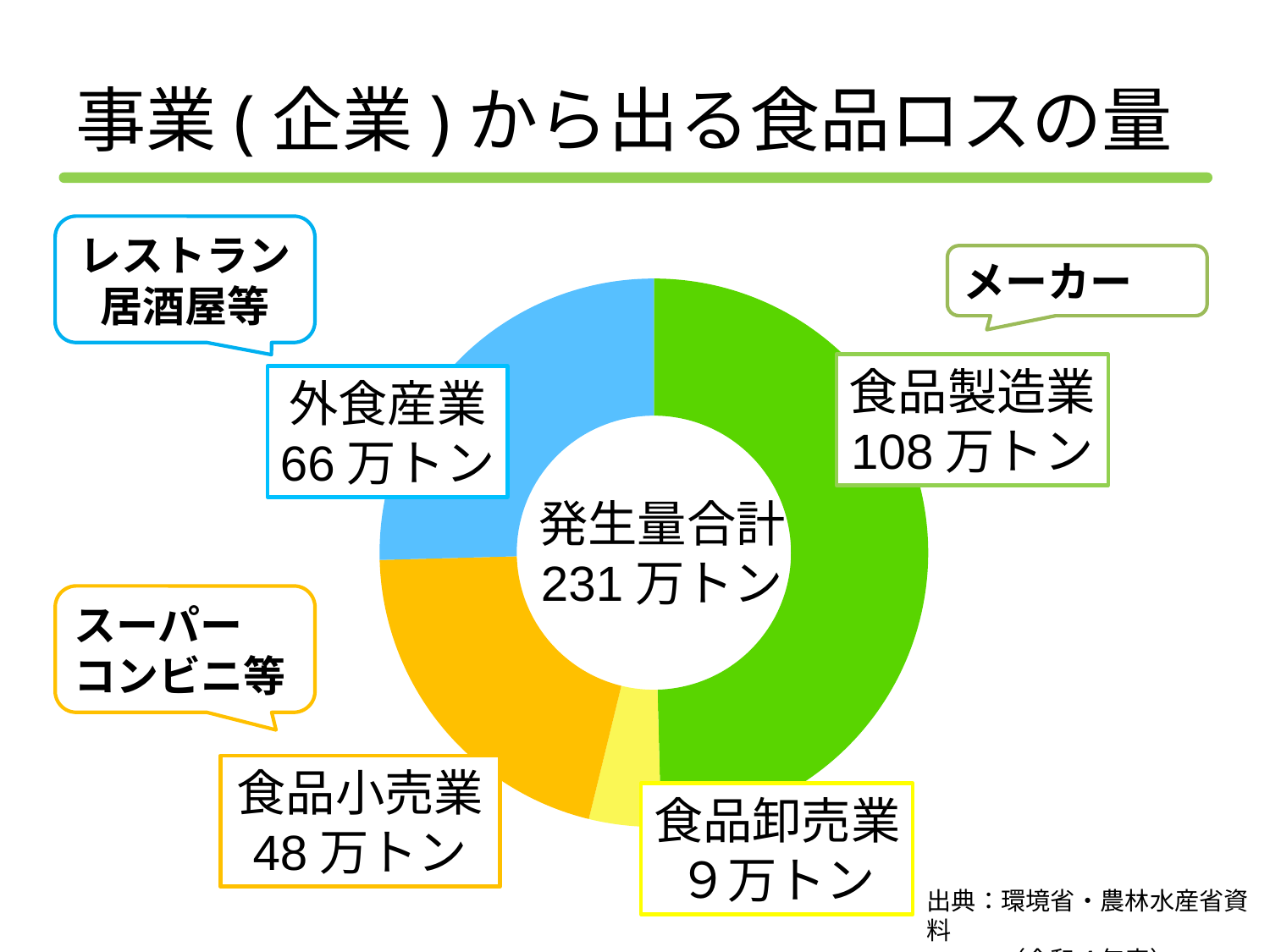
Which category has the lowest value? 食品卸売業 What is the value for 食品卸売業? 9万トン What is the title of the slide? 事業(企業)から出る食品ロスの量 How many categories does the chart show? 4 What is the value for 食品小売業? 48万トン What is the value for 食品製造業? 108万トン Which is larger, 外食産業 or 食品小売業? 外食産業 Which category has the highest value? 食品製造業 What is the value for 外食産業? 66万トン What is the total amount (発生量合計) shown in the centre of the chart? 231万トン What kind of chart is shown on the slide? Pie chart (donut) What is the difference between 食品製造業 and 外食産業? 42万トン